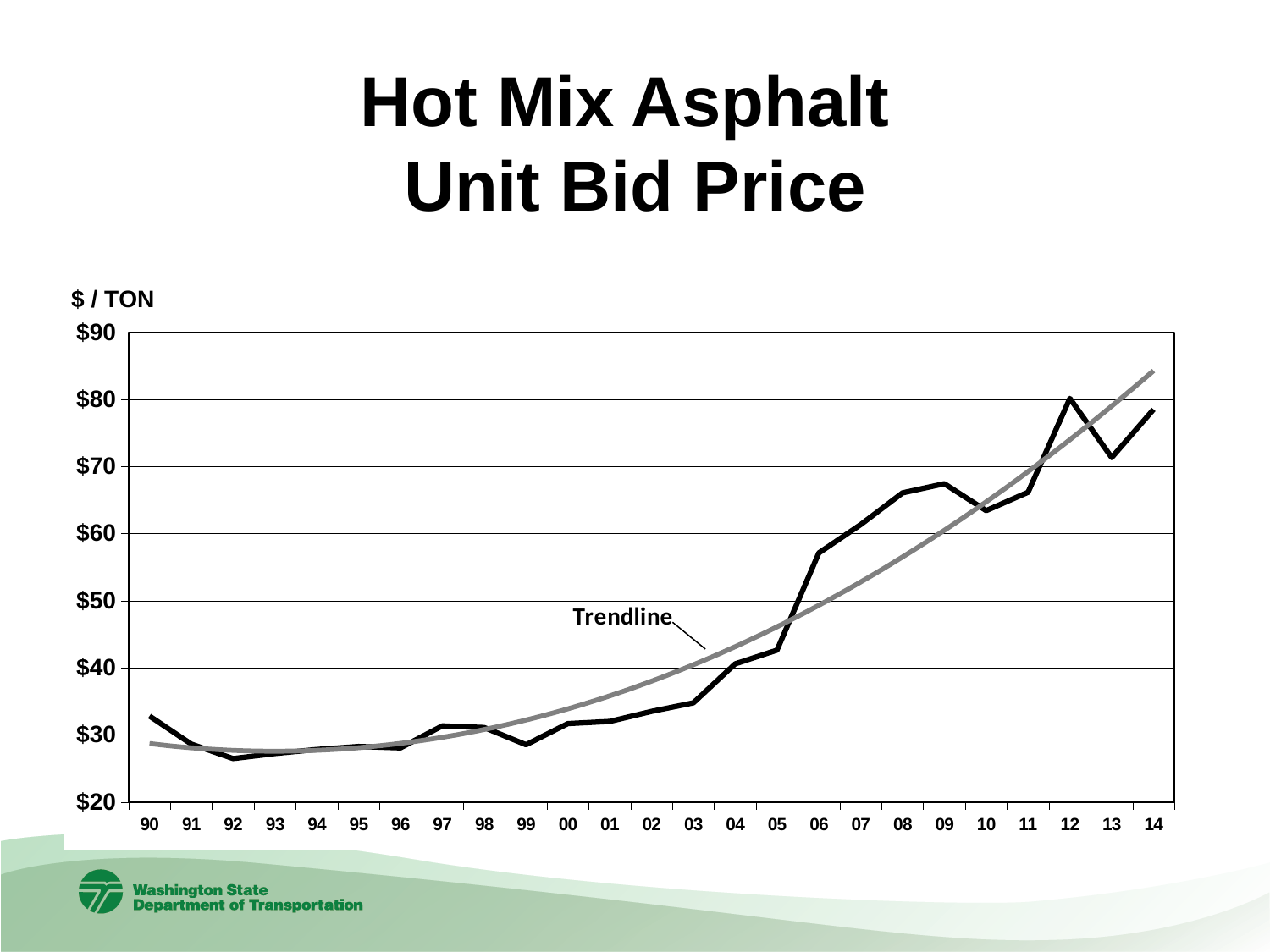
What kind of chart is shown on the slide? line chart Which year has the higher unit bid price, 05 or 06? 06 In which year does the black price line reach its lowest point? 92 Which year has the higher unit bid price, 12 or 13? 12 Is the unit bid price for 99 greater or less than $30? less How many years are plotted along the x axis? 25 What unit is shown on the y axis label? $ / TON In which year does the black price line reach its highest point? 12 Is the unit bid price for 03 greater or less than $40? less Overall, do the unit bid prices rise or fall from 90 to 14? rise Is the unit bid price for 06 greater or less than $50? greater